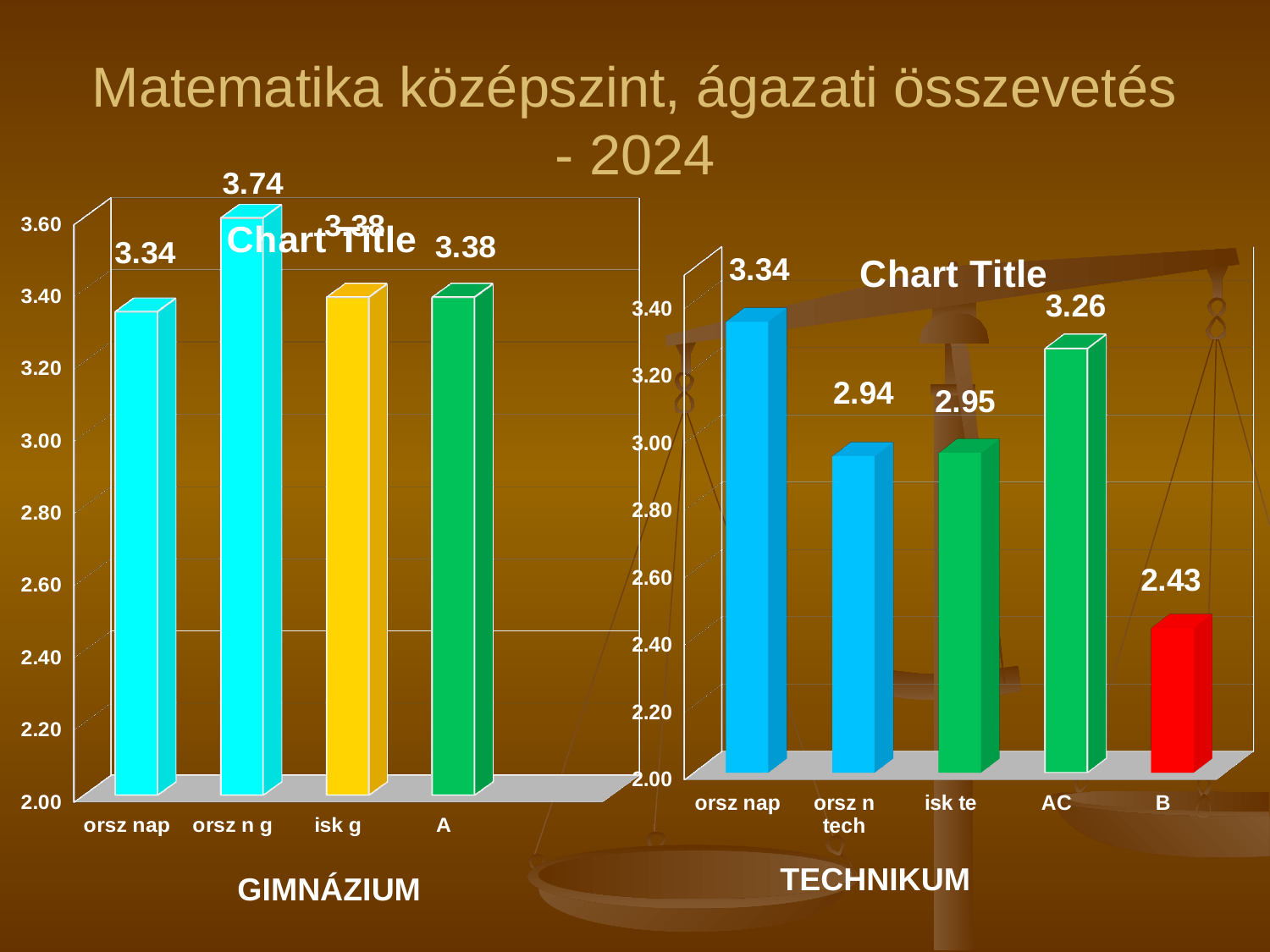
In the GIMNÁZIUM chart on the left, what is the value for orsz n g? 3.74 In the GIMNÁZIUM chart on the left, what is the difference between the values for orsz n g and orsz nap? 0.40 In the TECHNIKUM chart on the right, what is the value for B? 2.43 In the TECHNIKUM chart on the right, what is the difference between the values for orsz nap and B? 0.91 In the TECHNIKUM chart on the right, which category has the lowest value? B In the TECHNIKUM chart on the right, which category has the highest value? orsz nap In the GIMNÁZIUM chart on the left, what is the value for orsz nap? 3.34 In the GIMNÁZIUM chart on the left, which category has the highest value? orsz n g In the TECHNIKUM chart on the right, which is larger, the value for AC or the value for isk te? AC How many categories are shown in the GIMNÁZIUM chart on the left? 4 In the TECHNIKUM chart on the right, what is the value for AC? 3.26 What kind of chart is the TECHNIKUM chart on the right? bar chart